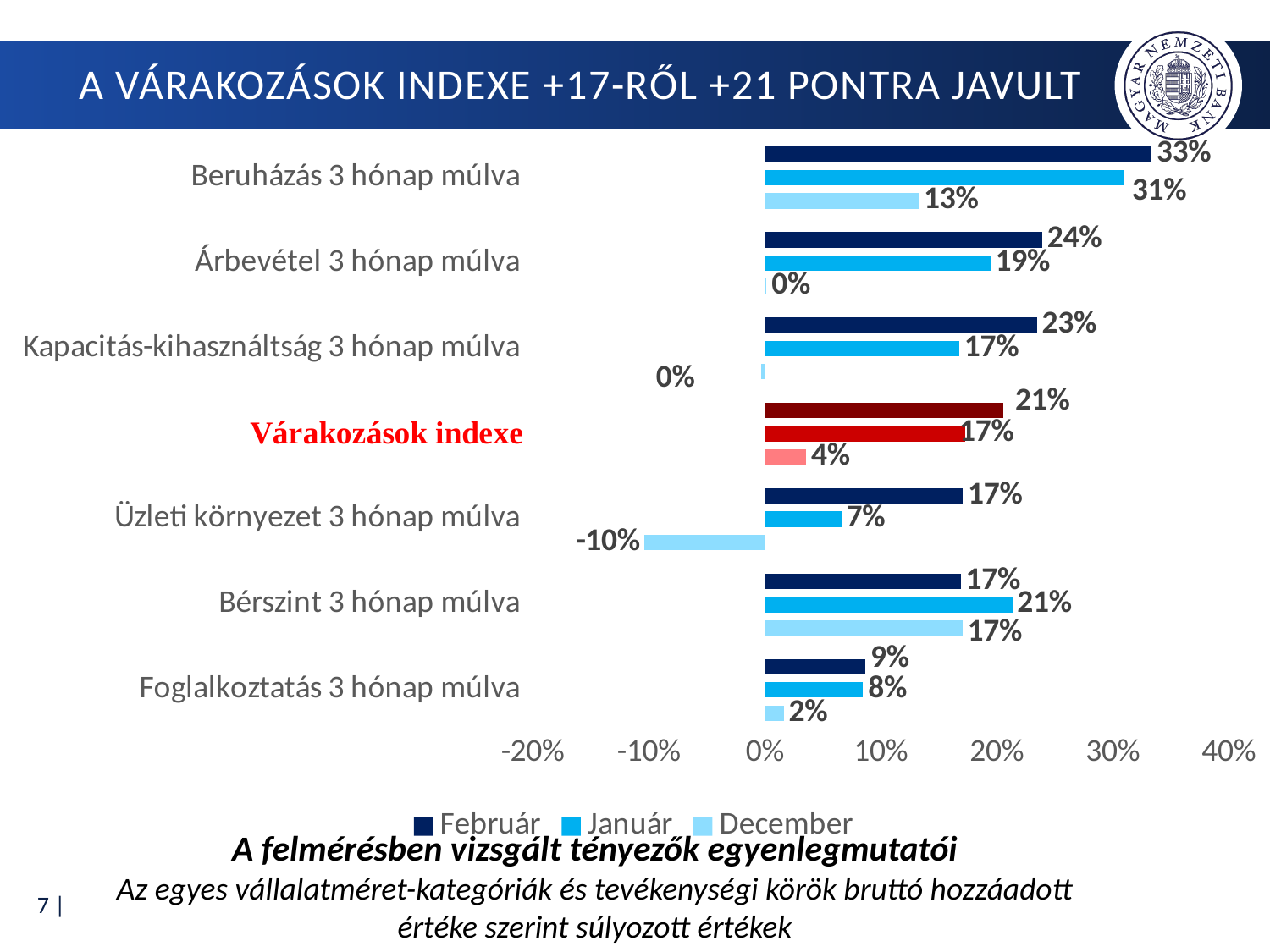
Which series is shown in the lightest blue colour in the legend? December What kind of chart is shown on the slide? Bar chart Which is larger for Bérszint 3 hónap múlva: the Február value or the Január value? Január How many series does the legend list? 3 Which category has the lowest December value? Üzleti környezet 3 hónap múlva How many categories are shown on the chart? 7 Which category has the highest Február value? Beruházás 3 hónap múlva What is the December value for Üzleti környezet 3 hónap múlva? -10% What is the difference between the Február and Január values for Várakozások indexe? 4% What is the Február value for Beruházás 3 hónap múlva? 33% What is the December value for Várakozások indexe? 4% What is the Január value for Bérszint 3 hónap múlva? 21%